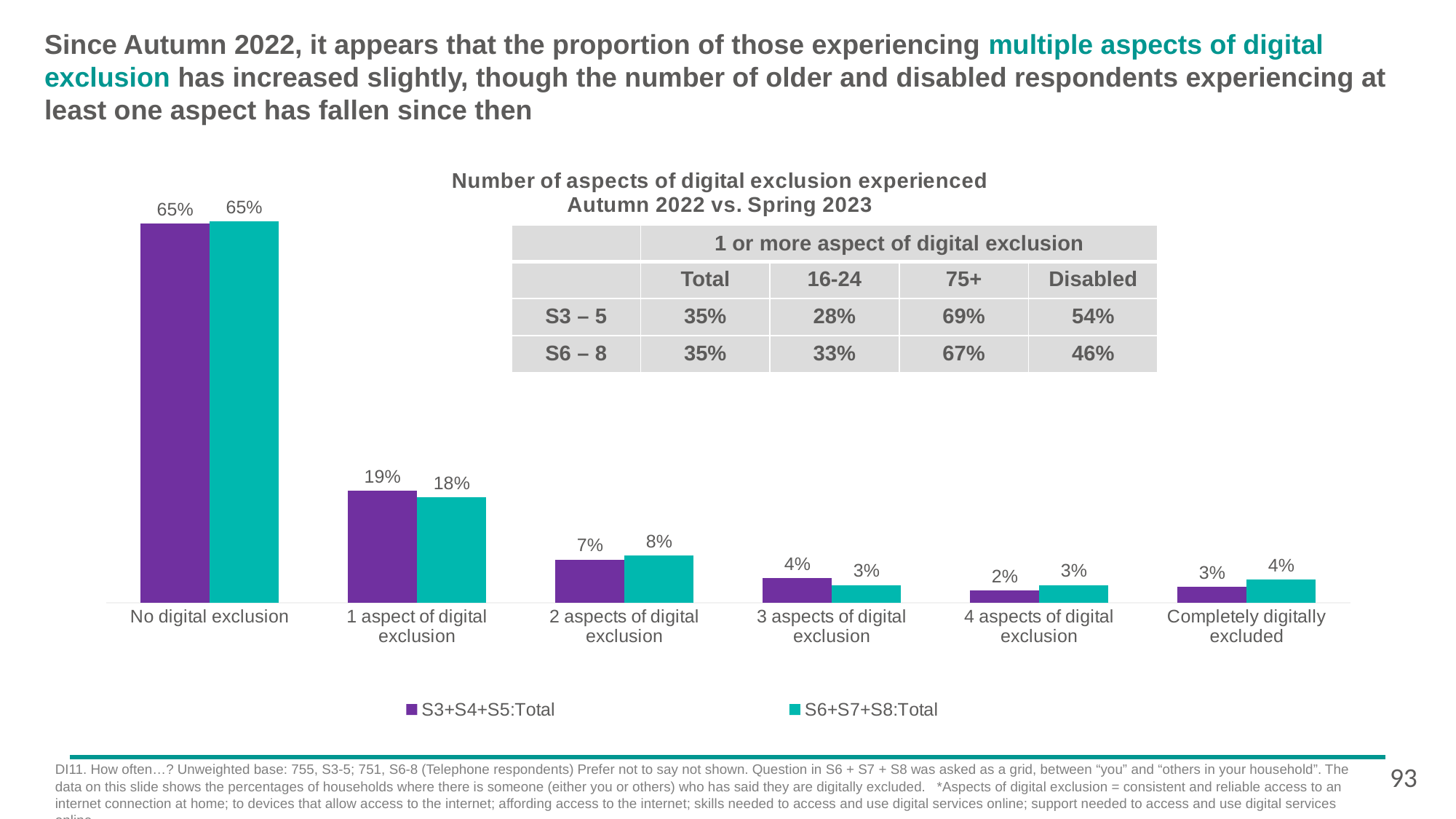
For '3 aspects of digital exclusion', which series has the larger value, S3+S4+S5:Total or S6+S7+S8:Total? S3+S4+S5:Total What kind of chart is shown on the slide? Bar chart What is the value for '1 aspect of digital exclusion' in the S6+S7+S8:Total series? 18% How many categories are shown on the x axis of the bar chart? 6 Which category has the lowest value in the S3+S4+S5:Total series? 4 aspects of digital exclusion What is the difference between the S3+S4+S5:Total and S6+S7+S8:Total values for '2 aspects of digital exclusion'? 1% What is the value for '4 aspects of digital exclusion' in the S3+S4+S5:Total series? 2% What is the title of the chart on the slide? Number of aspects of digital exclusion experienced Autumn 2022 vs. Spring 2023 Which category has the highest value in the S6+S7+S8:Total series? No digital exclusion What is the value for 'No digital exclusion' in the S3+S4+S5:Total series? 65% How many series does the legend of the bar chart list? 2 What is the value for 'Completely digitally excluded' in the S6+S7+S8:Total series? 4%